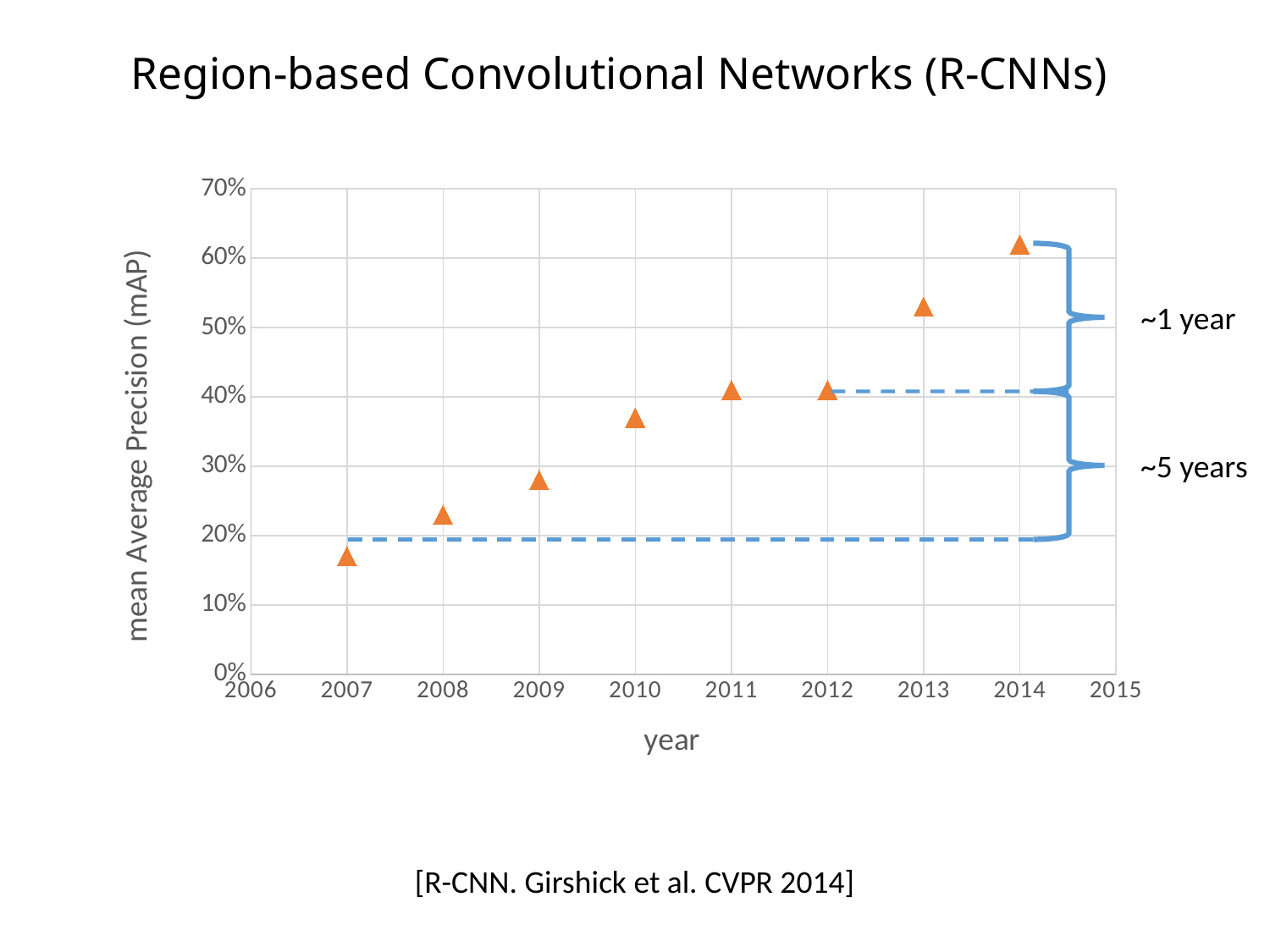
Is the value for 2013 greater or less than 50%? greater How many data points are plotted on the chart? 8 Is the value for 2007 greater or less than 20%? less Is the value for 2009 greater or less than 30%? less What is the label of the vertical axis? mean Average Precision (mAP) What kind of chart is shown on the slide? scatter chart Do the mAP values generally rise or fall from 2007 to 2014? rise Which year has the lowest mean Average Precision? 2007 Which year has the highest mean Average Precision? 2014 Which year has a higher mAP, 2010 or 2013? 2013